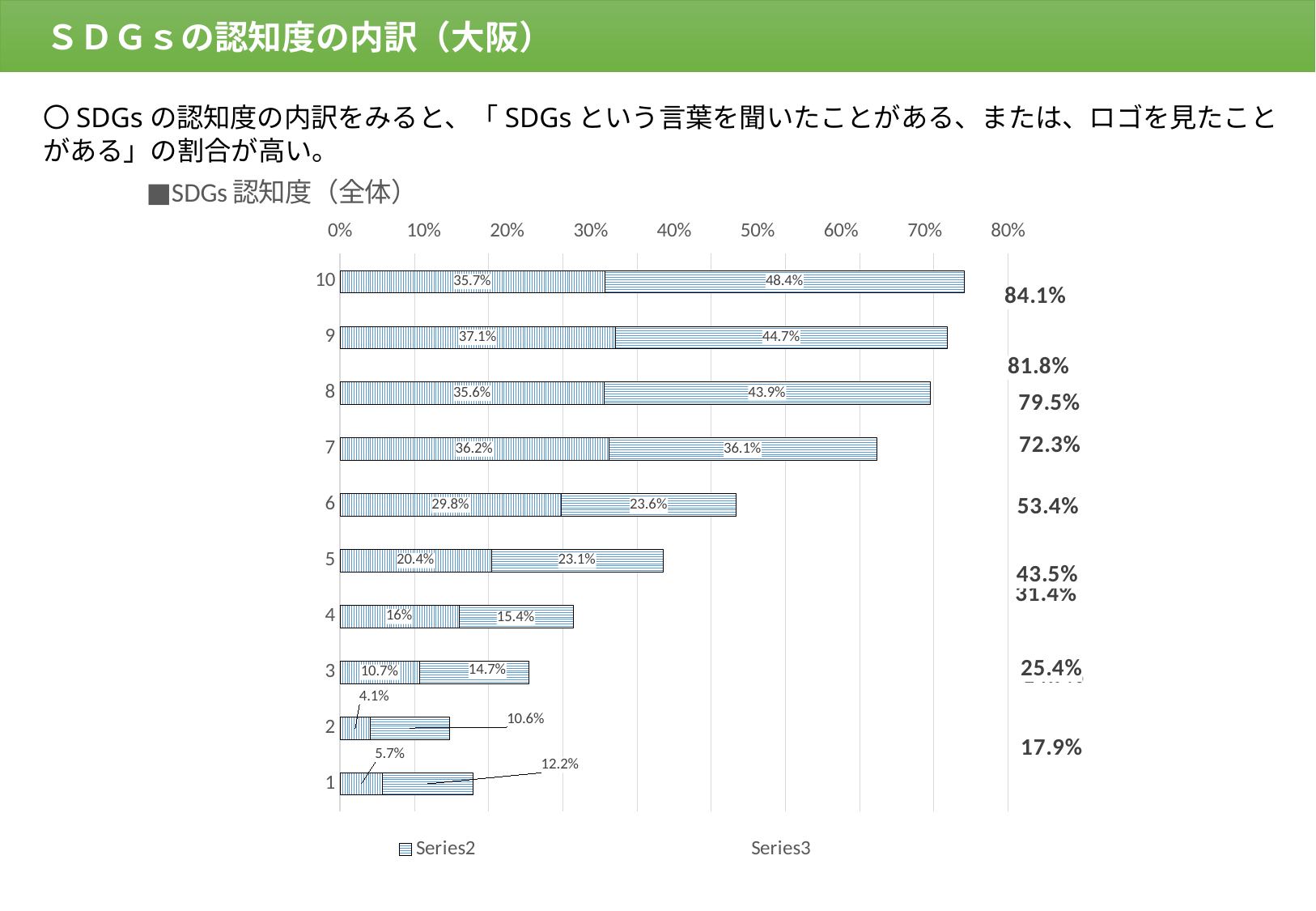
Which category has the highest Series3 value? 10 What is the title printed above the chart? ■SDGs 認知度（全体） What is the difference between the Series3 values for category 10 and category 9? 3.7% How many series does the legend list? 2 What kind of chart is shown on the slide? bar chart How many categories are plotted on the chart? 10 Which category has the lowest Series2 value? 2 Which is larger, the Series2 value for category 6 or the Series2 value for category 5? category 6 What is the total of the stacked bar for category 8? 79.5% What is the Series2 value for category 2? 4.1% What is the Series3 value for category 7? 36.1% What is the Series2 value for category 10? 35.7%